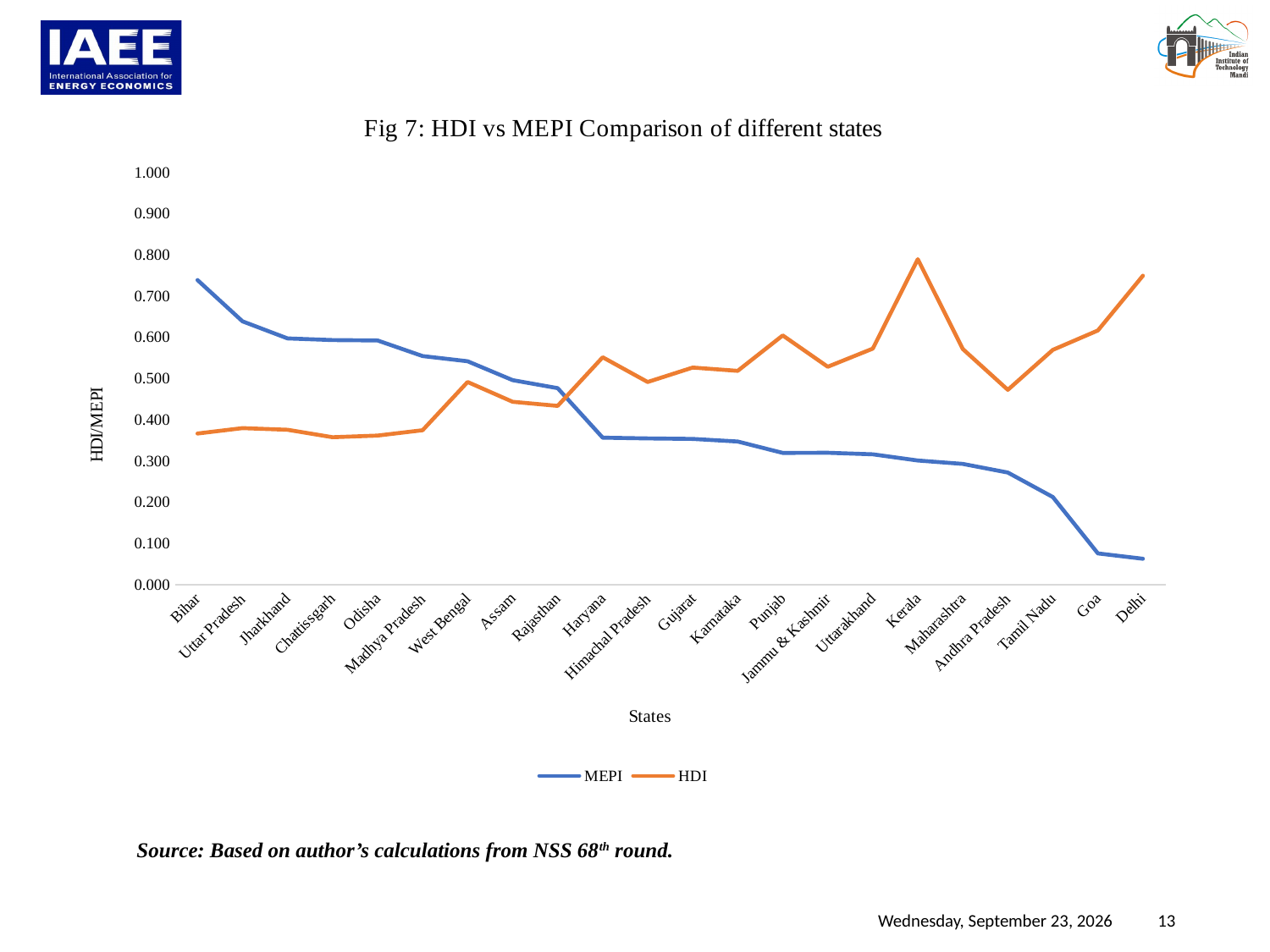
Is the MEPI value for Bihar greater or less than 0.700? greater Which state has the lowest MEPI value? Delhi What kind of chart is shown on the slide? Line chart Which state has the highest MEPI value? Bihar Is the MEPI value for Goa greater or less than 0.100? less How many states are plotted along the x axis? 22 What is the title of the chart? Fig 7: HDI vs MEPI Comparison of different states How many series does the legend list? 2 For Delhi, which is larger, the MEPI value or the HDI value? HDI Which state has the highest HDI value? Kerala Is the HDI value for Kerala greater or less than 0.700? greater Does the MEPI line generally rise or fall moving from Bihar to Delhi along the x axis? Fall